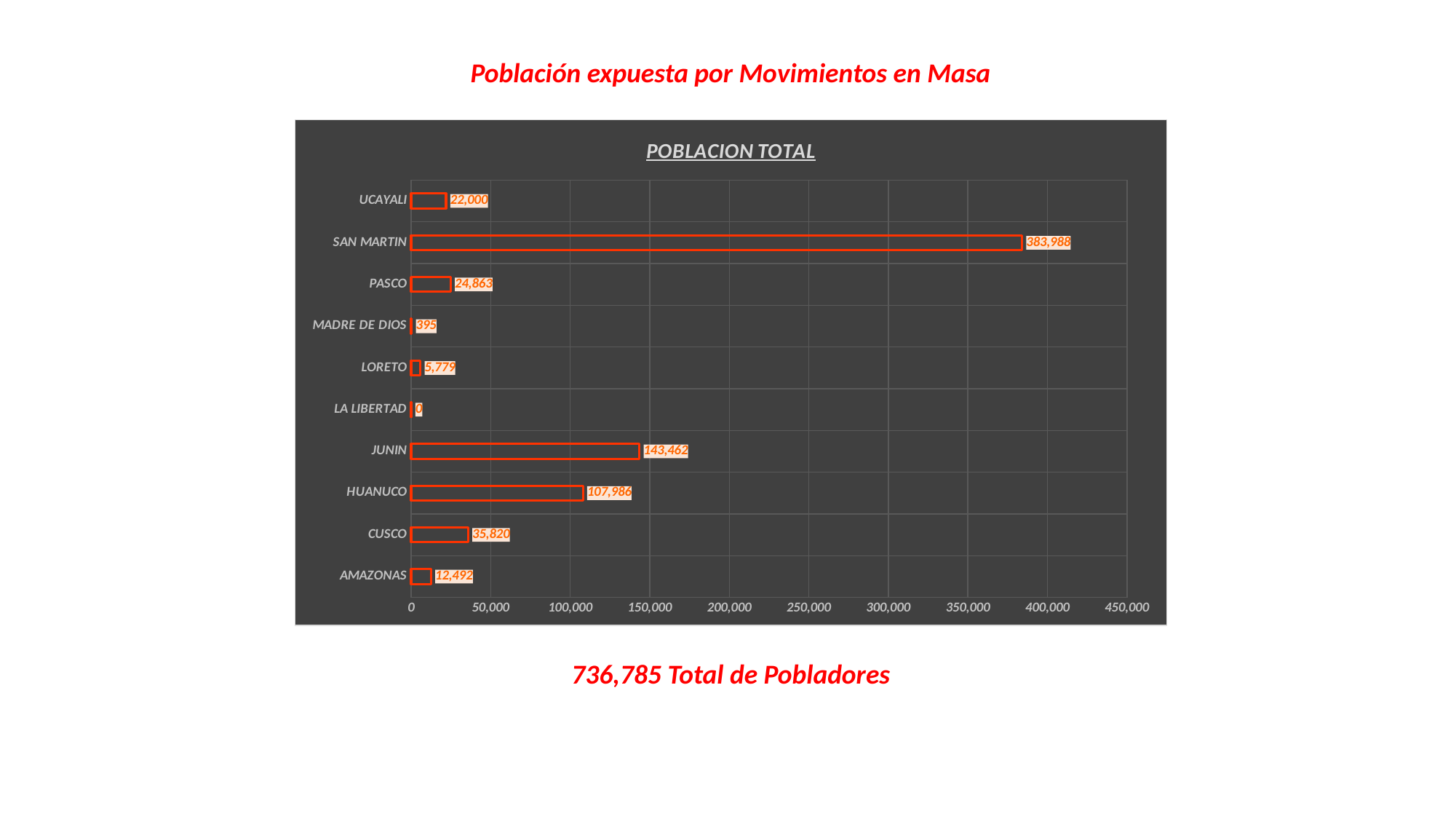
What is the difference between the values for JUNIN and HUANUCO? 35,476 What is the value for LA LIBERTAD? 0 Which category has the highest value? SAN MARTIN Which category has the lowest value? LA LIBERTAD How many categories are shown in the chart? 10 What is the value for JUNIN? 143,462 Which is larger, the value for CUSCO or the value for PASCO? CUSCO What kind of chart is shown on the slide? bar chart What is the title of the chart? POBLACION TOTAL What is the value for MADRE DE DIOS? 395 Is the value for HUANUCO greater or less than 100,000? greater What is the value for SAN MARTIN? 383,988